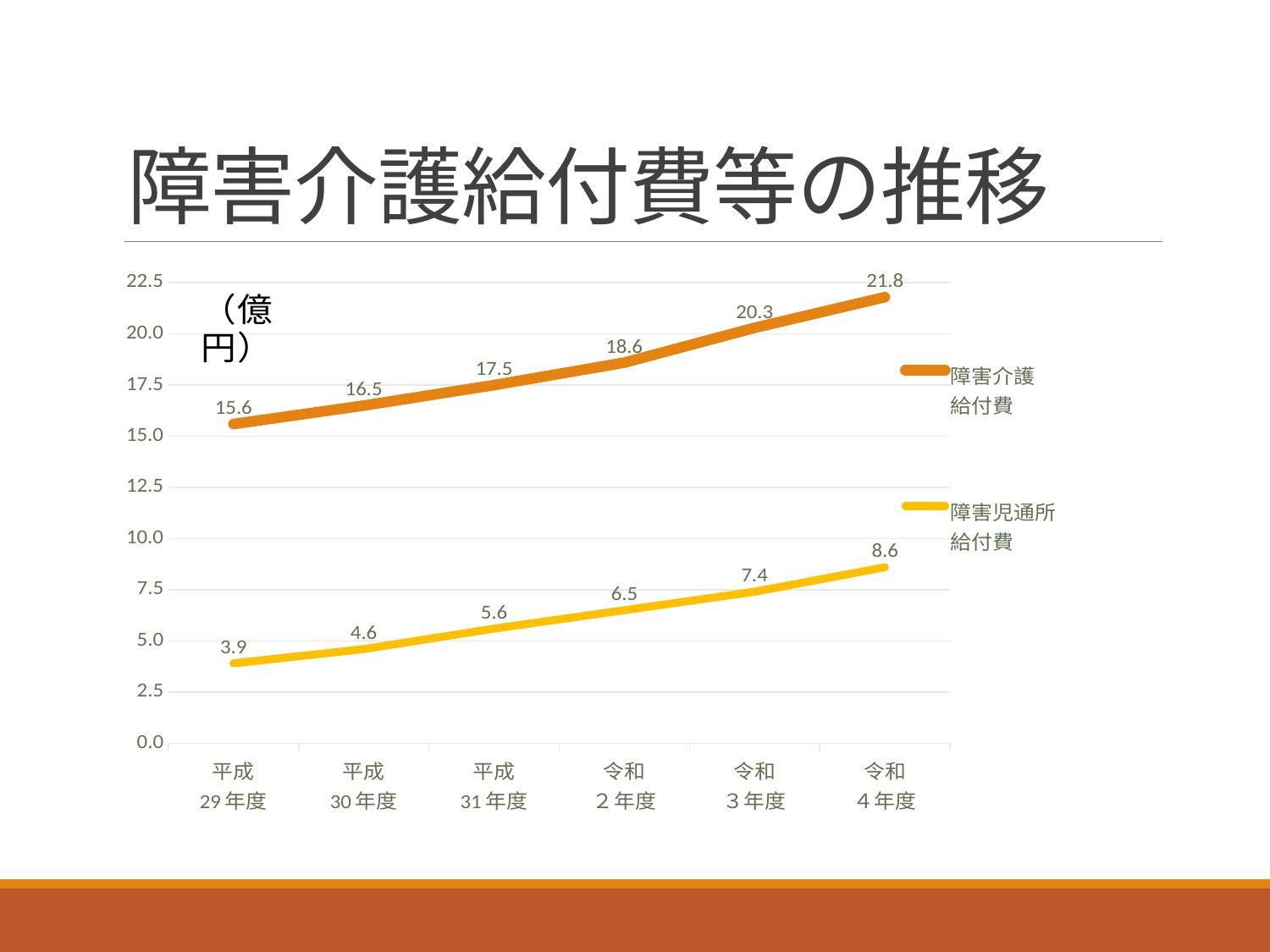
What is the value of 障害児通所給付費 for 令和4年度? 8.6 What is the value of 障害介護給付費 for 令和2年度? 18.6 In which year is 障害児通所給付費 lowest? 平成29年度 Which is larger in 平成30年度: 障害介護給付費 or 障害児通所給付費? 障害介護給付費 How many years are shown on the x axis? 6 How many series does the legend list? 2 What is the value of 障害児通所給付費 for 平成31年度? 5.6 What is the difference between 障害介護給付費 and 障害児通所給付費 in 令和3年度? 12.9 What kind of chart is shown on the slide? line chart What is the difference between 障害介護給付費 in 令和4年度 and 平成29年度? 6.2 What is the value of 障害介護給付費 for 平成29年度? 15.6 In which year is 障害介護給付費 highest? 令和4年度